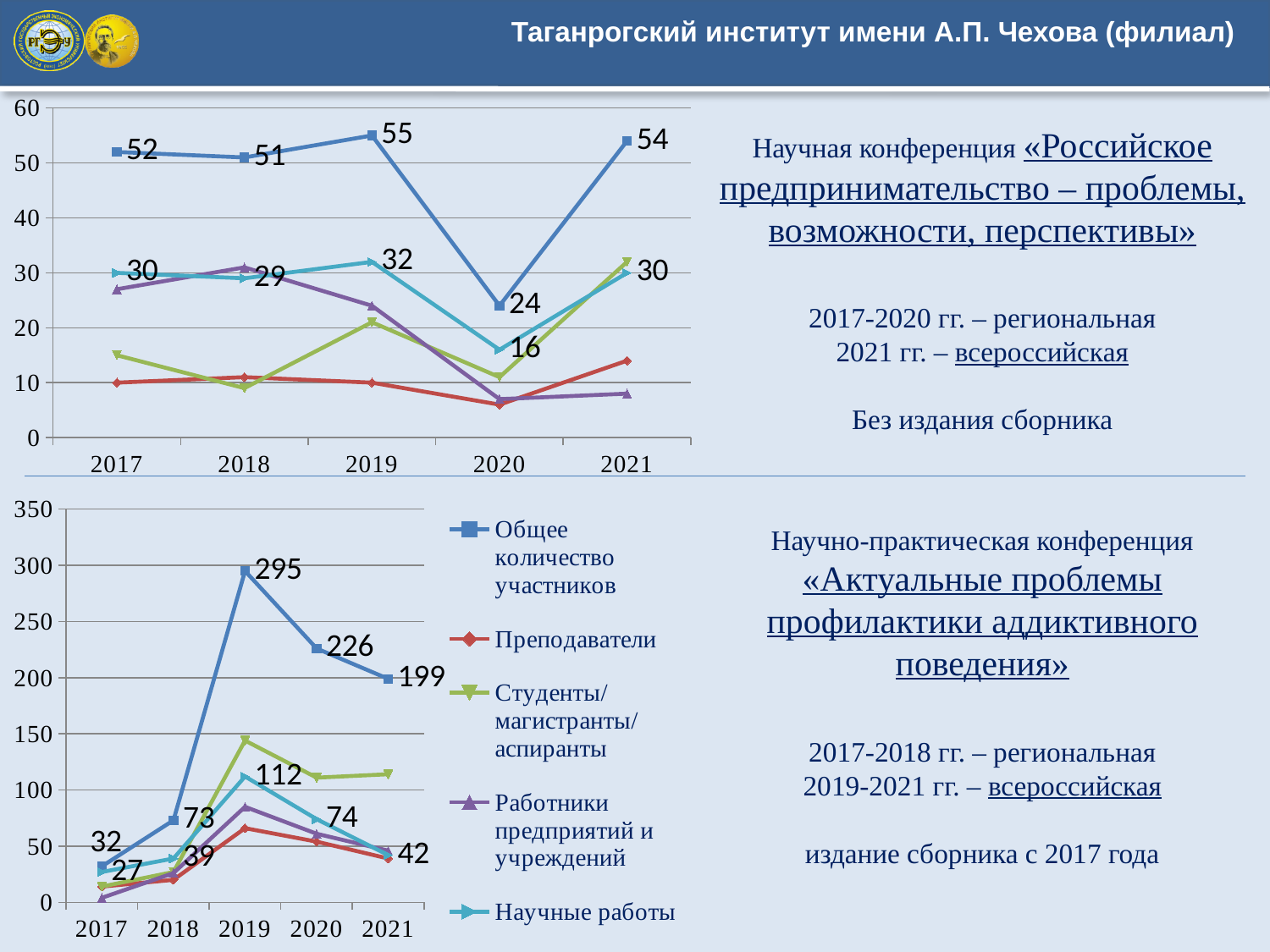
How many series does the legend of the bottom chart list? 5 In the top chart, what is the difference between Общее количество участников in 2019 and in 2020? 31 In the bottom chart, what is the value for Научные работы in 2019? 112 In the bottom chart, what is the difference between Общее количество участников in 2020 and in 2021? 27 In the bottom chart, which is larger: Общее количество участников in 2017 or in 2018? 2018 In the top chart, in which year is Общее количество участников lowest? 2020 What kind of chart is the bottom chart? line chart In the bottom chart, what is the value for Общее количество участников in 2019? 295 In the top chart, what is the value for Общее количество участников in 2019? 55 In the bottom chart, in which year is Общее количество участников highest? 2019 In the top chart, what is the value for Научные работы in 2021? 30 In the top chart, is the value for Преподаватели in 2021 greater or less than 20? less